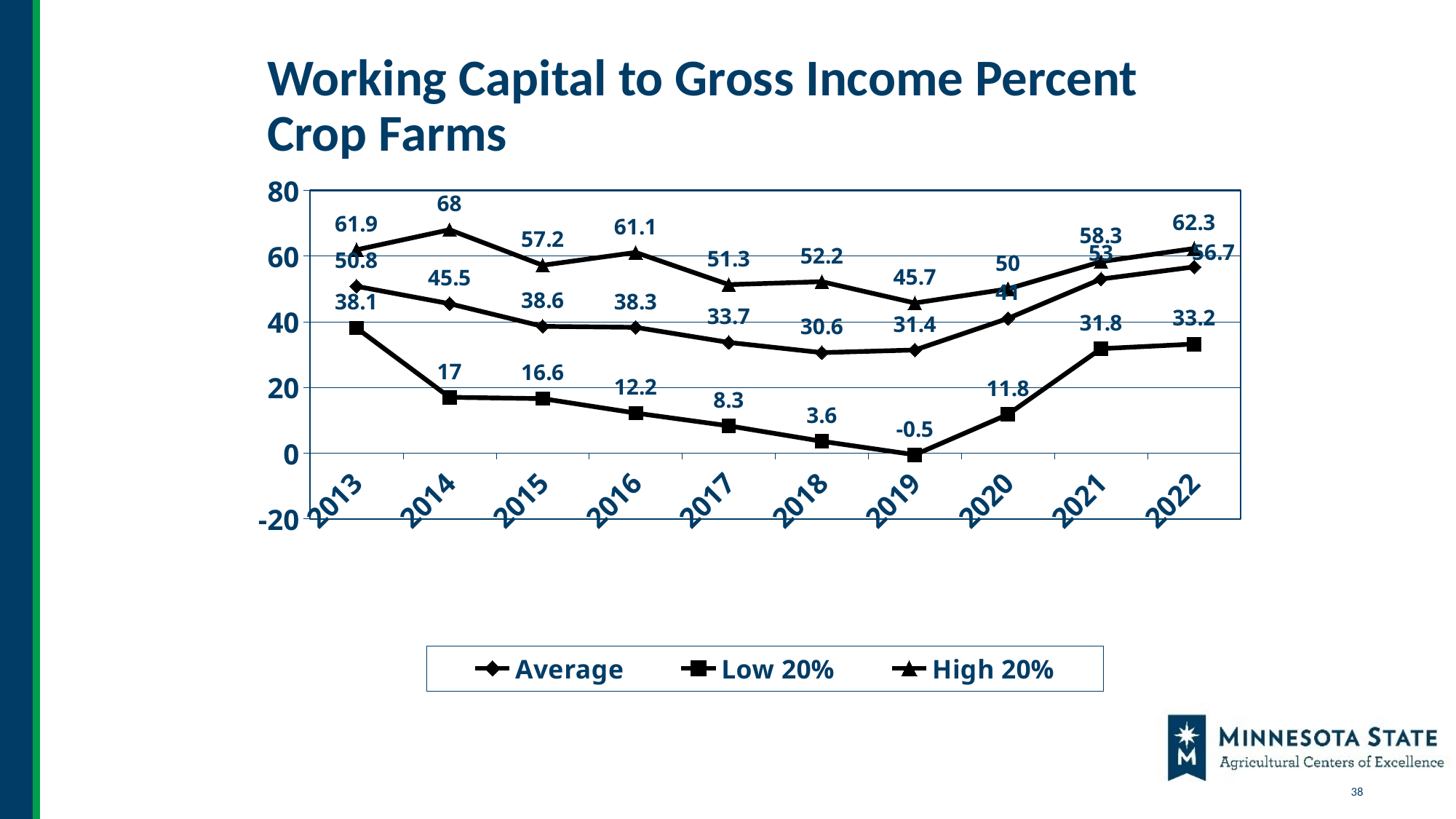
Does the Low 20% series rise or fall from 2013 to 2019? fall What is the difference between the High 20% and Low 20% values in 2022? 29.1 What is the Low 20% value in 2019? -0.5 How many series does the legend list? 3 How many years are plotted along the x axis? 10 Is the Average value larger in 2013 or in 2022? 2022 What is the High 20% value in 2014? 68 What kind of chart is shown on the slide? line chart In which year is the High 20% series at its highest? 2014 In which year is the Low 20% series at its lowest? 2019 Is the Low 20% value for 2021 greater or less than 20? greater What is the Average value in 2018? 30.6